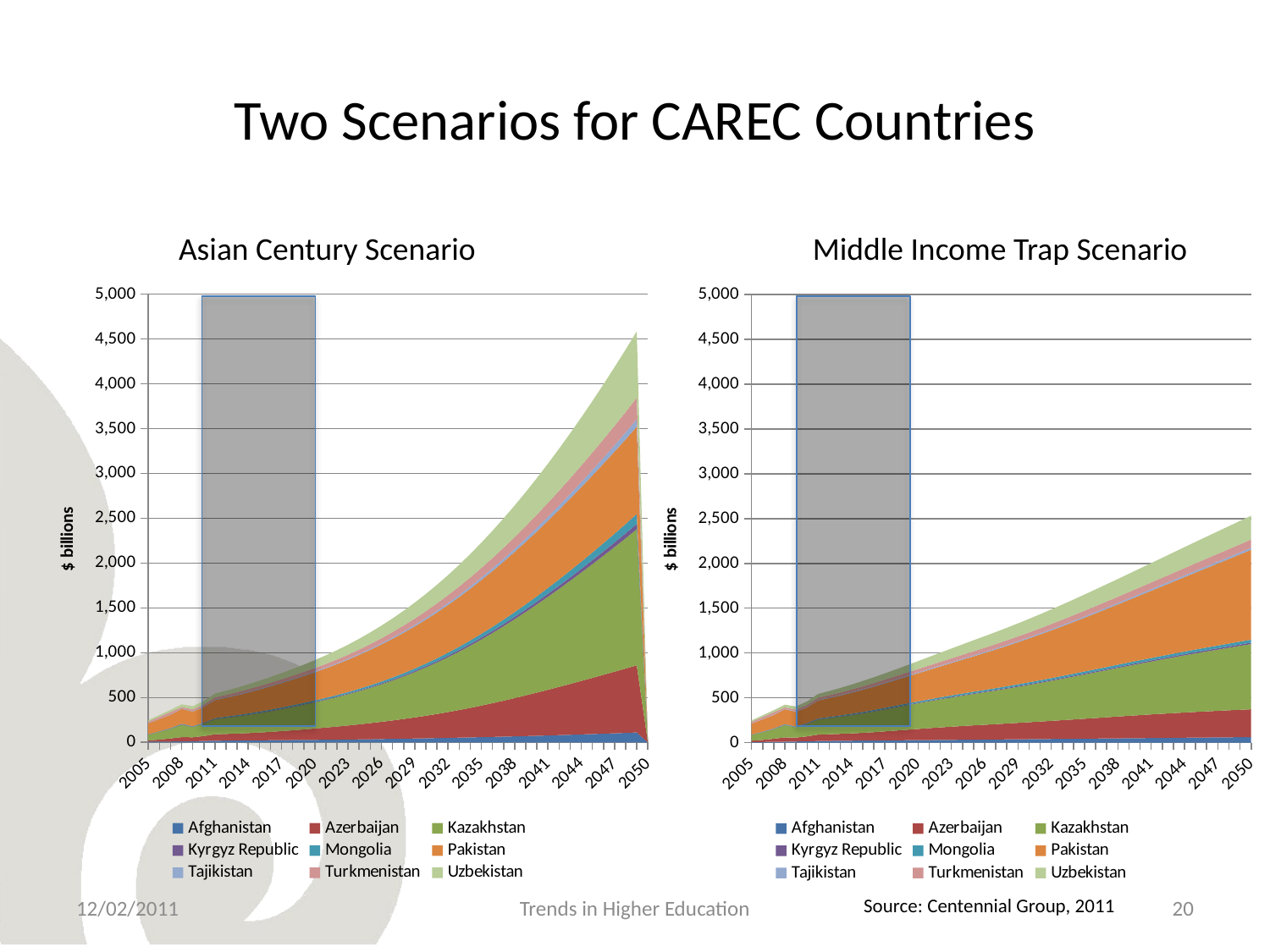
In the Middle Income Trap Scenario chart, is the total stacked value in 2050 greater or less than 2,000? greater In the Asian Century Scenario chart, which series has the larger band in 2047, Kazakhstan or Pakistan? Kazakhstan In the Middle Income Trap Scenario chart, which series has the larger band in 2050, Pakistan or Kazakhstan? Pakistan What is the highest value shown on the y-axis of the Middle Income Trap Scenario chart? 5,000 What is the y-axis label on the Asian Century Scenario chart? $ billions In the Middle Income Trap Scenario chart, is the total stacked value in 2020 greater or less than 1,000? less In the Asian Century Scenario chart, is the total stacked value in 2041 greater or less than 2,000? greater In the Asian Century Scenario chart, do the total stacked values rise or fall from 2005 to 2047? rise Which scenario chart reaches a higher total stacked value by the late 2040s, Asian Century or Middle Income Trap? Asian Century Scenario What kind of chart is the Asian Century Scenario chart? Stacked area chart How many series does the legend of the Middle Income Trap Scenario chart list? 9 How many year labels are shown on the x-axis of the Asian Century Scenario chart? 16